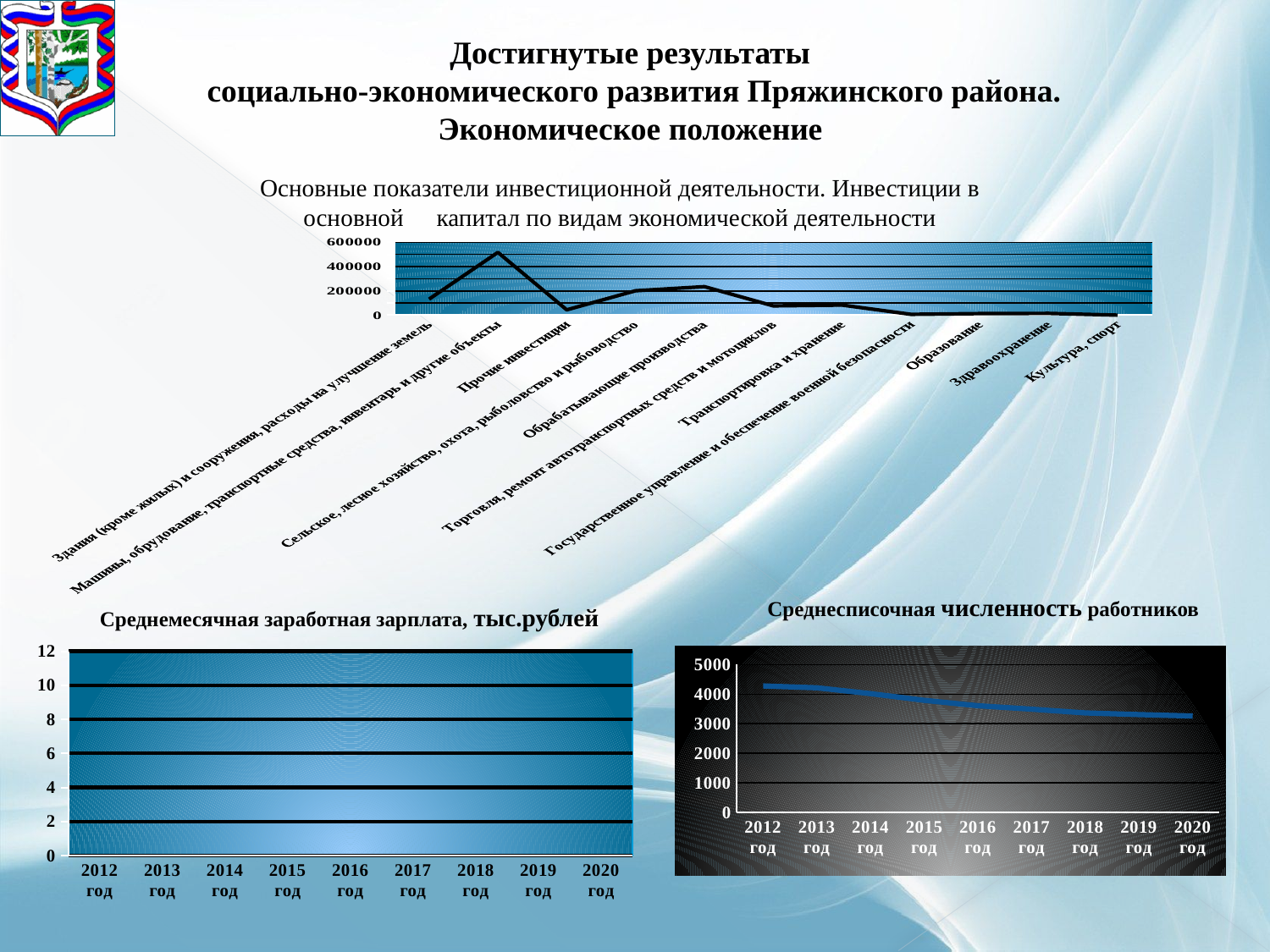
On the top chart (investments in fixed capital by type of economic activity), how many categories are labelled on the x axis? 11 On the top chart (investments in fixed capital by type of economic activity), is the value for 'Прочие инвестиции' greater or less than 200000? less What kind of chart is the top chart (investments in fixed capital by type of economic activity)? line chart On the chart 'Среднемесячная заработная зарплата, тыс.рублей', what is the highest value shown on the y axis? 12 On the top chart (investments in fixed capital by type of economic activity), is the value for 'Машины, оборудование, транспортные средства, инвентарь и другие объекты' greater or less than 400000? greater On the top chart (investments in fixed capital by type of economic activity), which category has the highest value? Машины, оборудование, транспортные средства, инвентарь и другие объекты On the chart 'Среднесписочная численность работников', is the value for 2012 год greater or less than 4000? greater On the chart 'Среднесписочная численность работников', do the values rise or fall from 2012 to 2020? fall On the chart 'Среднесписочная численность работников', how many years are shown on the x axis? 9 On the top chart (investments in fixed capital by type of economic activity), what is the highest value shown on the y axis? 600000 On the top chart (investments in fixed capital by type of economic activity), which is larger: the value for 'Машины, оборудование, транспортные средства, инвентарь и другие объекты' or the value for 'Прочие инвестиции'? Машины, оборудование, транспортные средства, инвентарь и другие объекты